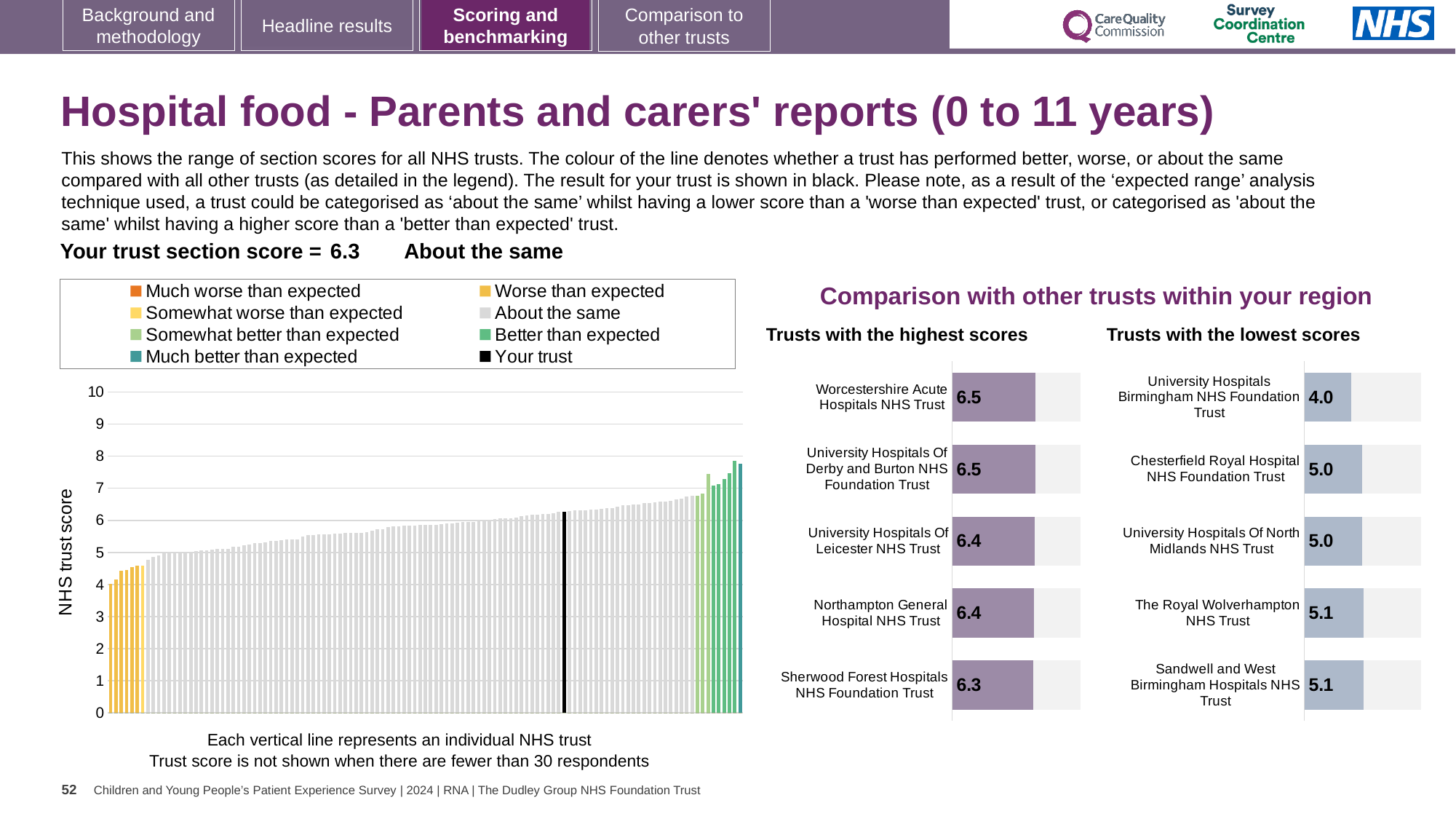
In the 'Trusts with the lowest scores' chart, what is the score for University Hospitals Birmingham NHS Foundation Trust? 4.0 In the 'Trusts with the highest scores' chart, what is the score for Worcestershire Acute Hospitals NHS Trust? 6.5 In the large chart on the left showing the range of section scores, is the value for the black 'Your trust' bar greater or less than 6? greater In the 'Trusts with the highest scores' chart, what is the score for Sherwood Forest Hospitals NHS Foundation Trust? 6.3 In the large chart on the left, do the trust scores rise or fall from left to right along the x axis? rise How many trusts are shown in the 'Trusts with the lowest scores' chart? 5 In the 'Trusts with the lowest scores' chart, which trust has the lowest score? University Hospitals Birmingham NHS Foundation Trust In the 'Trusts with the highest scores' chart, which trust has the lowest score? Sherwood Forest Hospitals NHS Foundation Trust In the 'Trusts with the lowest scores' chart, what is the score for The Royal Wolverhampton NHS Trust? 5.1 In the 'Trusts with the lowest scores' chart, what is the difference between the scores of Sandwell and West Birmingham Hospitals NHS Trust and University Hospitals Birmingham NHS Foundation Trust? 1.1 In the 'Trusts with the highest scores' chart, what is the difference between the scores of Worcestershire Acute Hospitals NHS Trust and Sherwood Forest Hospitals NHS Foundation Trust? 0.2 Which has a higher score: University Hospitals Of Leicester NHS Trust in the highest scores chart, or Chesterfield Royal Hospital NHS Foundation Trust in the lowest scores chart? University Hospitals Of Leicester NHS Trust